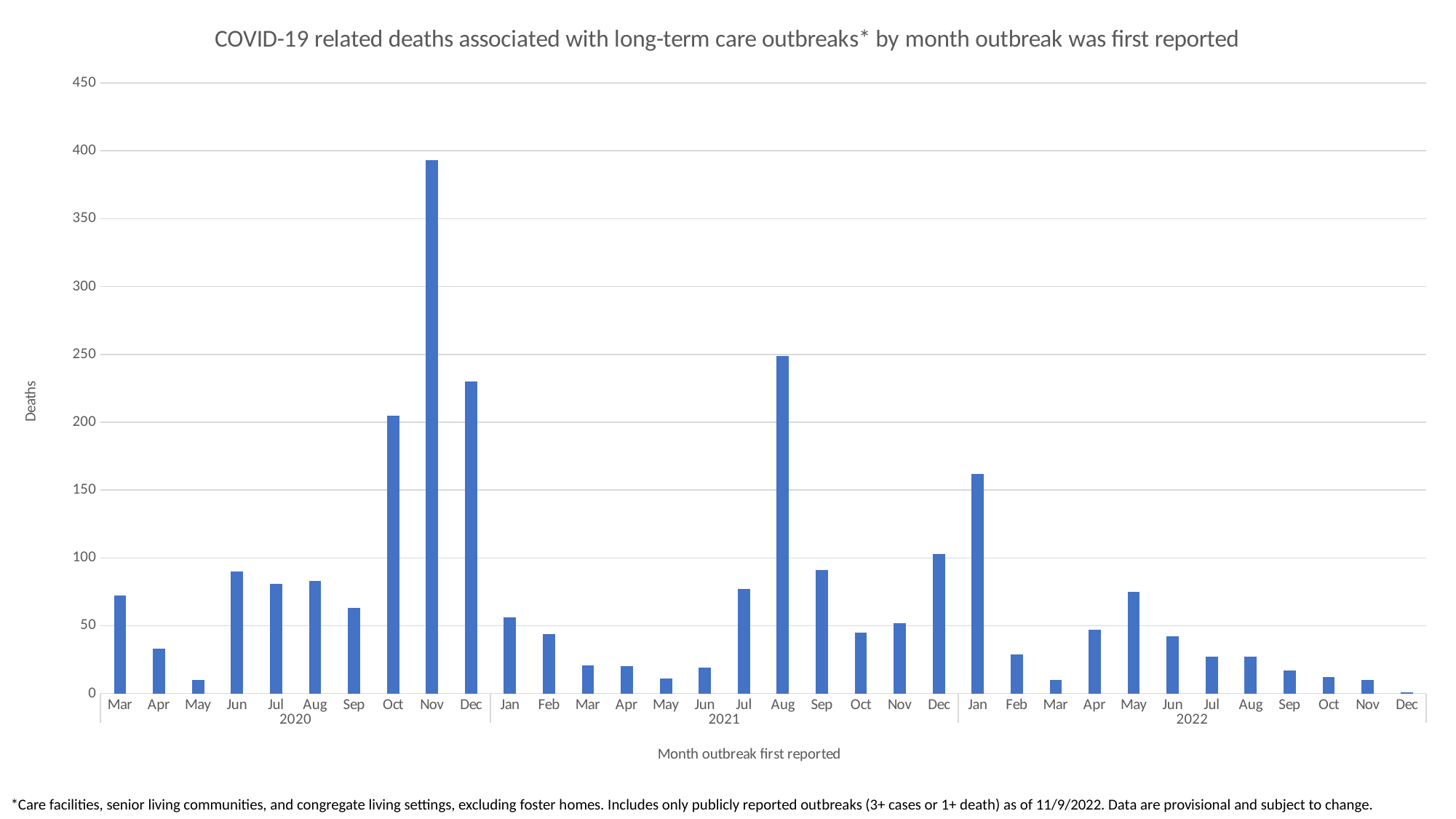
Which has more deaths, Jan 2022 or Dec 2021? Jan 2022 How many monthly bars are plotted on the chart? 34 Which month has the lowest number of deaths? Dec 2022 Is the value for Jan 2022 greater or less than 150? greater Is the value for May 2021 greater or less than 50? less What is the label on the vertical axis? Deaths Do the values generally rise or fall from Jan 2022 to Dec 2022? fall What kind of chart is shown on the slide? bar chart Is the value for Aug 2021 greater or less than 200? greater Which has more deaths, Nov 2020 or Aug 2021? Nov 2020 Which month has the highest number of deaths? Nov 2020